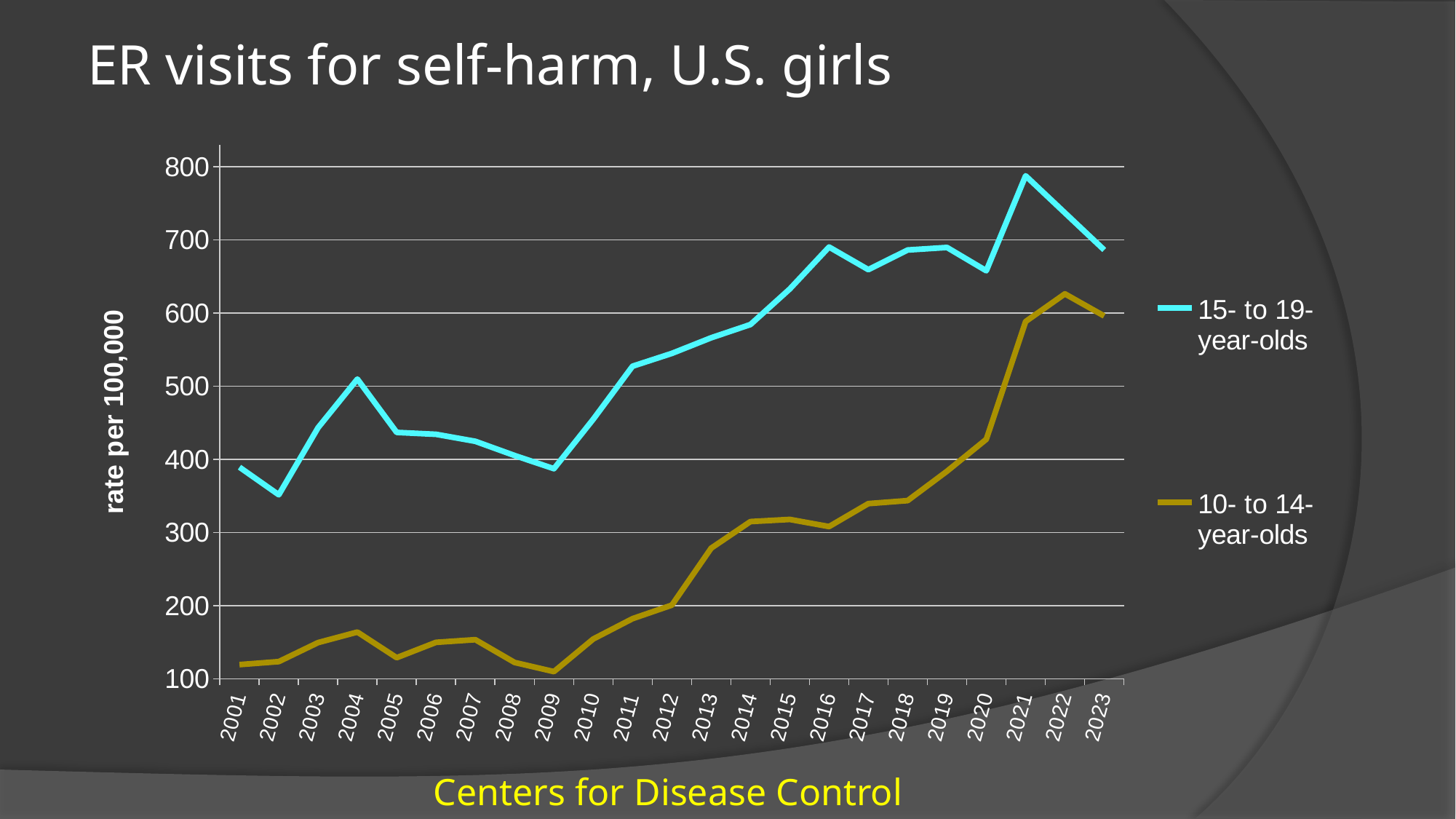
Does the 10- to 14-year-olds line rise or fall between 2012 and 2022? rise How many series does the legend list? 2 In which year does the 15- to 19-year-olds line reach its lowest value? 2002 What is the label on the y axis? rate per 100,000 In 2023, which series has the higher value, 15- to 19-year-olds or 10- to 14-year-olds? 15- to 19-year-olds What kind of chart is shown on the slide? line chart Is the value for 15- to 19-year-olds in 2021 greater or less than 700? greater In which year does the 15- to 19-year-olds line reach its highest value? 2021 In which year does the 10- to 14-year-olds line reach its highest value? 2022 How many years are plotted along the x axis? 23 Is the value for 10- to 14-year-olds in 2012 greater or less than 300? less Is the value for 10- to 14-year-olds in 2021 greater or less than 500? greater